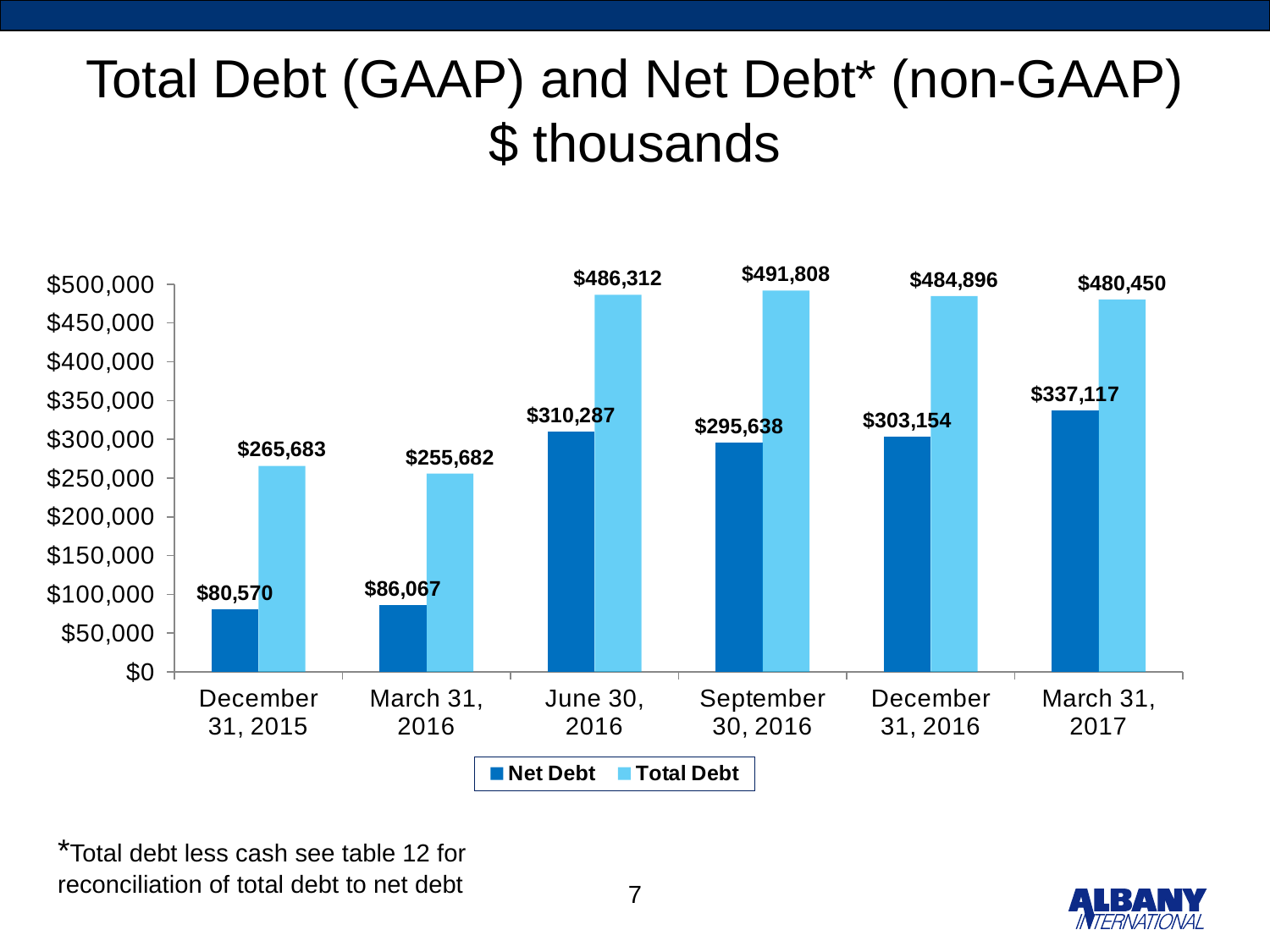
What is the Net Debt value for June 30, 2016? $310,287 How many series does the legend list? 2 What unit is stated in the chart title? $ thousands Is the Total Debt for March 31, 2016 greater or less than $300,000? less Which date has the lowest Net Debt? December 31, 2015 Is the Net Debt for September 30, 2016 larger or smaller than the Net Debt for December 31, 2016? smaller What is the Total Debt value for December 31, 2015? $265,683 What kind of chart is shown on the slide? bar chart How many dates are shown on the x axis? 6 What is the difference between Total Debt and Net Debt on March 31, 2017? $143,333 What is the Net Debt value for March 31, 2017? $337,117 Which date has the highest Total Debt? September 30, 2016